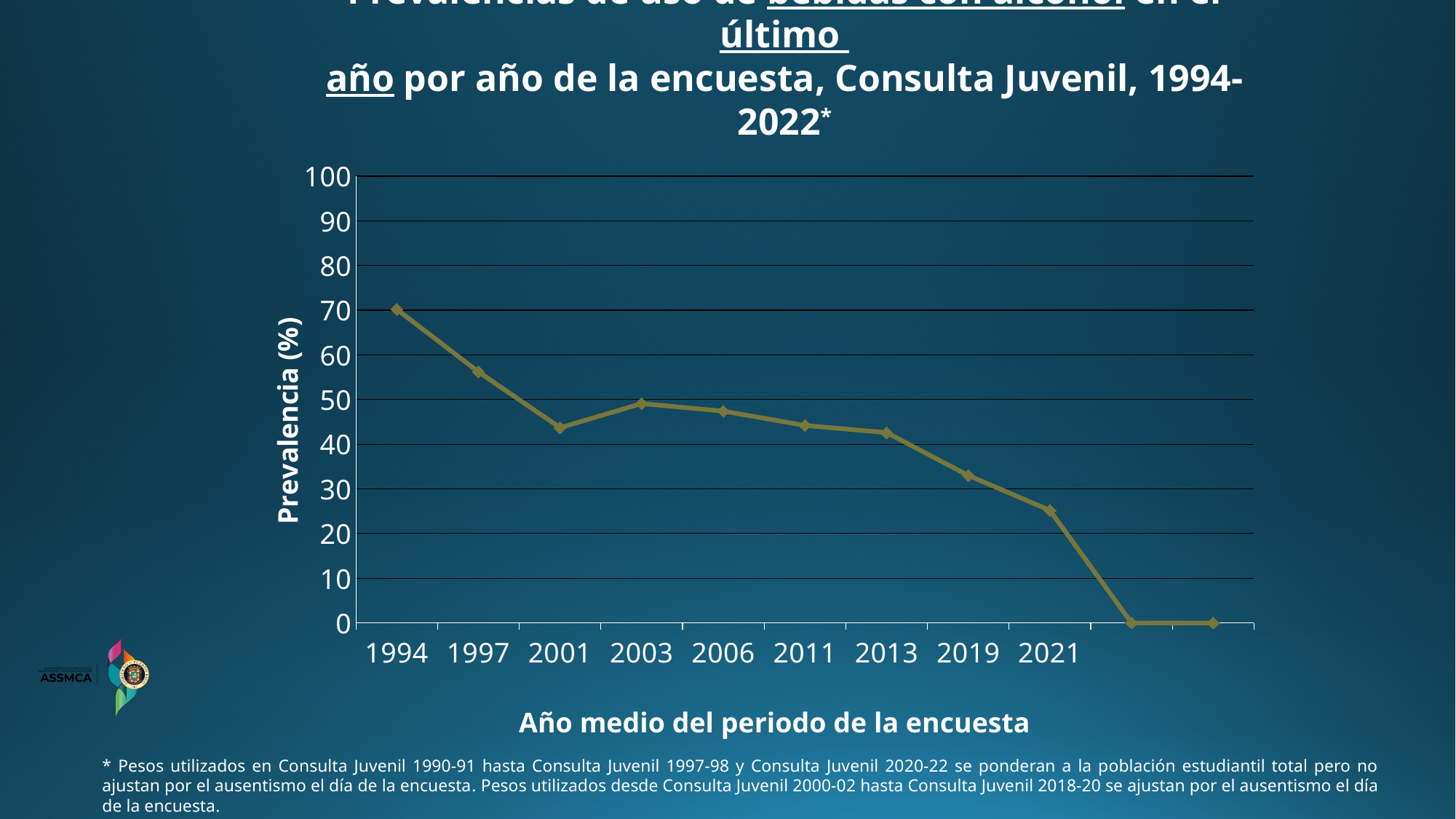
Which is larger, the value for 2001 or the value for 2003? 2003 What kind of chart is shown on the slide? line chart Is the value for 1994 greater or less than 60? greater Is the value for 2021 greater or less than 30? less Which is larger, the value for 2019 or the value for 2021? 2019 Which year has the highest prevalence value on the chart? 1994 Is the value for 2001 greater or less than 50? less What is the title of the horizontal axis? Año medio del periodo de la encuesta Overall, do the values rise or fall from 1994 to 2021? fall What is the title of the vertical axis? Prevalencia (%)